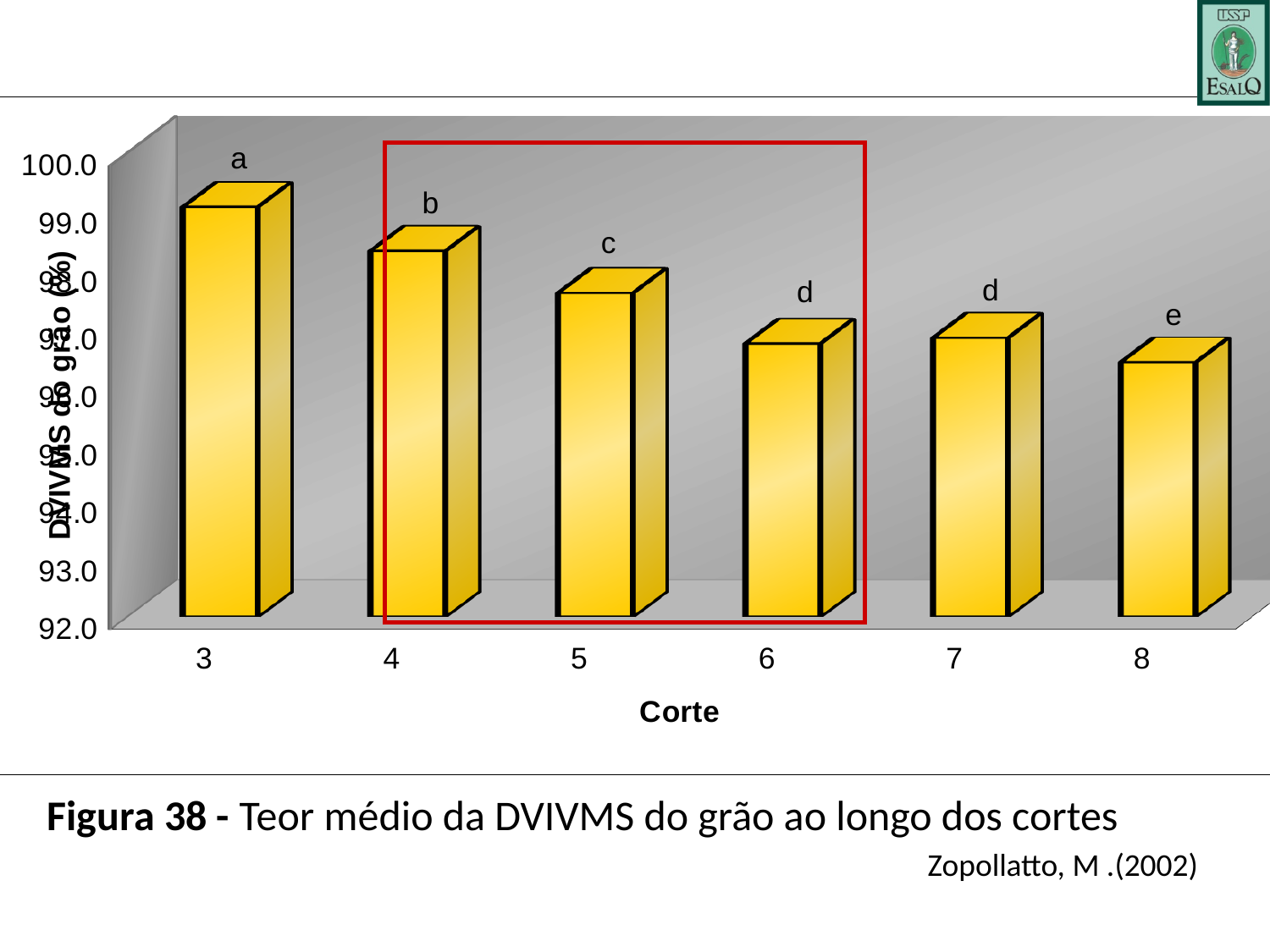
Do the DVIVMS do grão values generally rise or fall as the corte number increases from 3 to 8? fall Which has a higher DVIVMS do grão value, corte 4 or corte 6? corte 4 Is the value for corte 3 greater or less than 98.0? greater Is the value for corte 4 greater or less than 99.0? less Is the value for corte 5 greater or less than 98.0? less What kind of chart is shown on the slide? bar chart How many cortes (categories) are plotted on the x axis? 6 Which corte has the highest DVIVMS do grão value? 3 Which corte has the lowest DVIVMS do grão value? 8 Which letter is printed above the bar for corte 3? a What is the title of the x axis? Corte